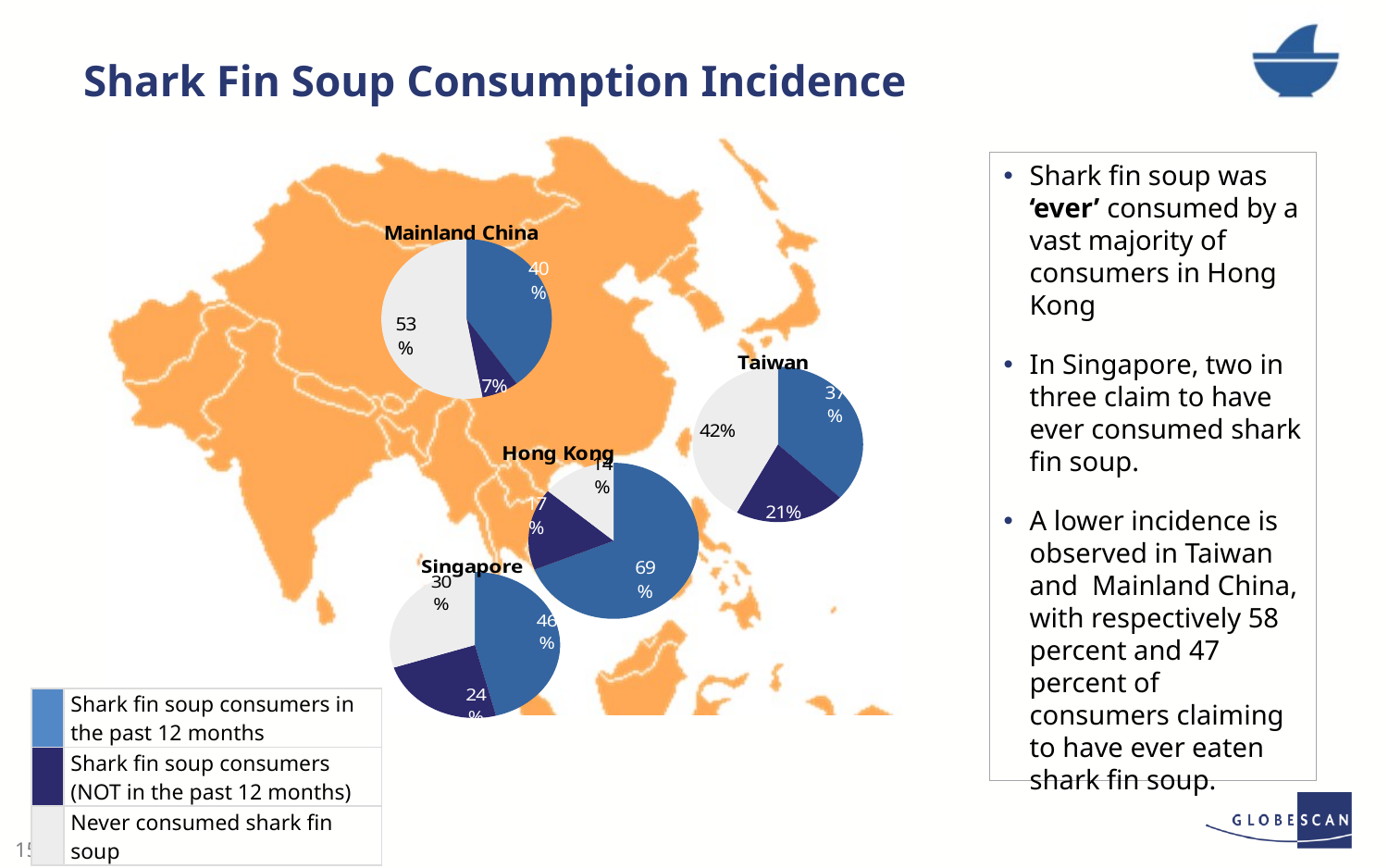
How many pie charts are shown on the map? 4 In the Mainland China pie chart, what share of consumers are shark fin soup consumers but NOT in the past 12 months? 7% In the Hong Kong pie chart, what share of consumers are shark fin soup consumers but NOT in the past 12 months? 17% In the Hong Kong pie chart, what share of consumers are shark fin soup consumers in the past 12 months? 69% What kind of chart is used to show shark fin soup consumption for each region on the slide? Pie chart In the Singapore pie chart, what share of consumers are shark fin soup consumers in the past 12 months? 46% In the Mainland China pie chart, what is the difference between the share who never consumed shark fin soup and the share who consumed it in the past 12 months? 13 percentage points In the Mainland China pie chart, what share of consumers never consumed shark fin soup? 53% Which region's pie chart shows the lowest share of consumers who never consumed shark fin soup? Hong Kong Which region's pie chart shows the highest share of shark fin soup consumers in the past 12 months? Hong Kong How many categories does the legend list for the pie charts? 3 In the Taiwan pie chart, what share of consumers never consumed shark fin soup? 42%